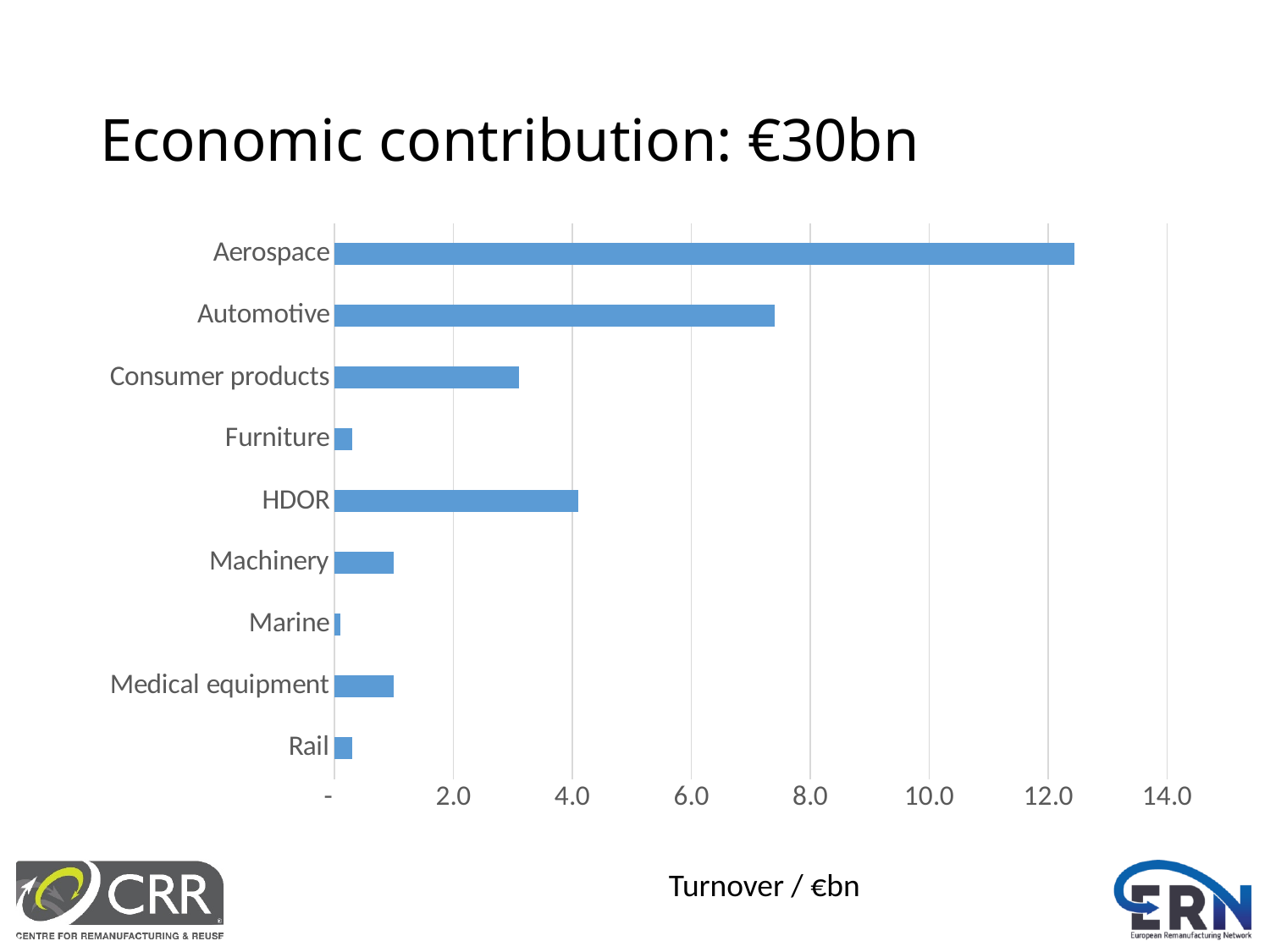
What is the label of the horizontal axis? Turnover / €bn Which has the larger turnover, Consumer products or HDOR? HDOR Which has the larger turnover, Automotive or HDOR? Automotive Which category has the highest turnover? Aerospace Is the value for HDOR greater or less than 6.0? less Is the value for Automotive greater or less than 8.0? less Is the value for Consumer products greater or less than 2.0? greater Which category has the lowest turnover? Marine How many categories are plotted on the chart? 9 What kind of chart is shown on the slide? Bar chart